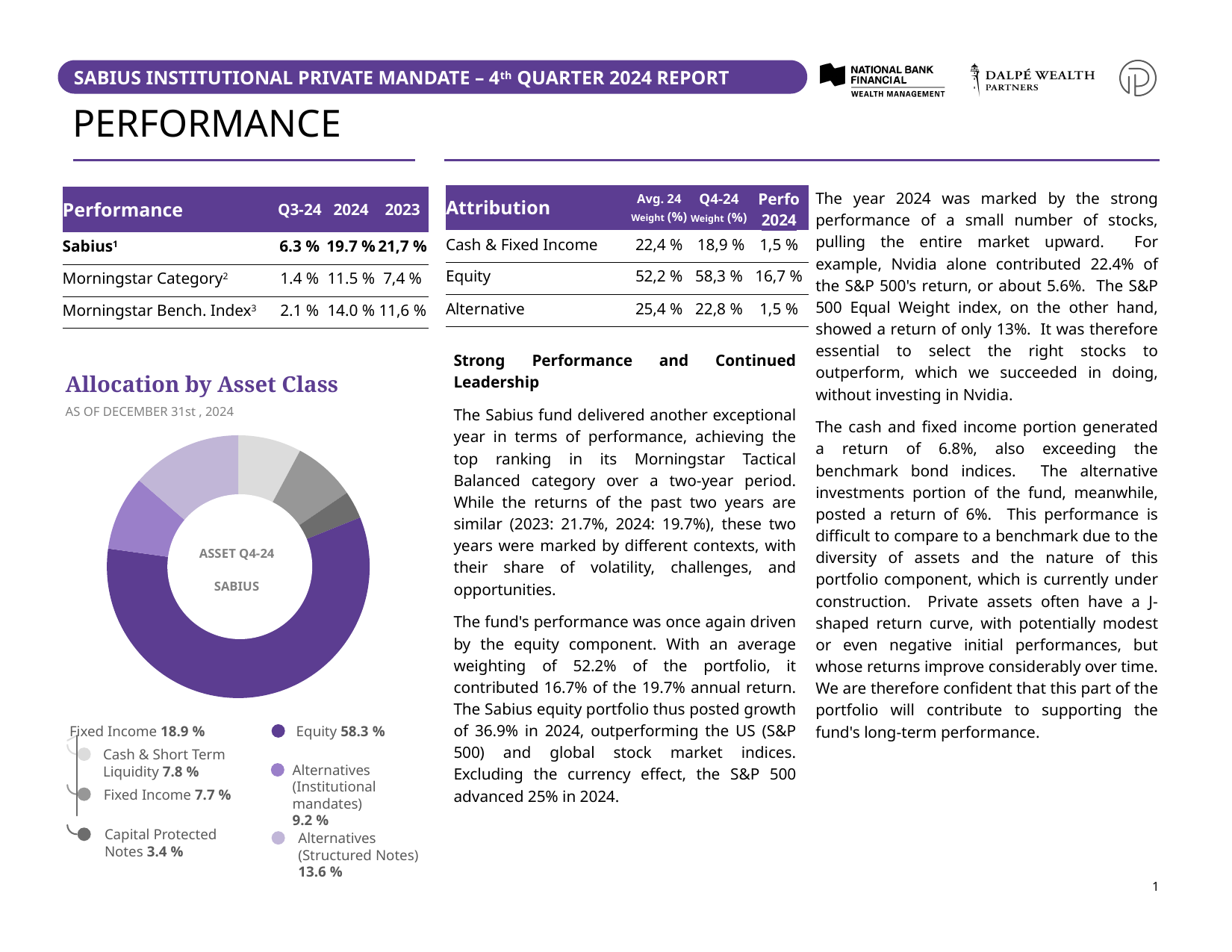
Which asset class has the largest slice in the "Allocation by Asset Class" chart? Equity Which asset class has the smallest slice in the "Allocation by Asset Class" chart? Capital Protected Notes As of what date is the "Allocation by Asset Class" chart reported? December 31st, 2024 In the "Allocation by Asset Class" chart, what is the share for Equity? 58.3 % In the "Allocation by Asset Class" chart, what is the difference between the Equity share and the Alternatives (Structured Notes) share? 44.7 % In the "Allocation by Asset Class" chart, what is the share for Cash & Short Term Liquidity? 7.8 % How many individual slices does the "Allocation by Asset Class" donut chart have? 6 In the "Allocation by Asset Class" chart, which is larger: Alternatives (Institutional mandates) or Capital Protected Notes? Alternatives (Institutional mandates) What is the combined share of Cash & Short Term Liquidity and Fixed Income shown under the Fixed Income group in the "Allocation by Asset Class" chart? 15.5 % In the "Allocation by Asset Class" chart, what is the share for Alternatives (Institutional mandates)? 9.2 % What kind of chart is the "Allocation by Asset Class" chart? Pie (donut) chart In the "Allocation by Asset Class" chart, what is the share for Alternatives (Structured Notes)? 13.6 %